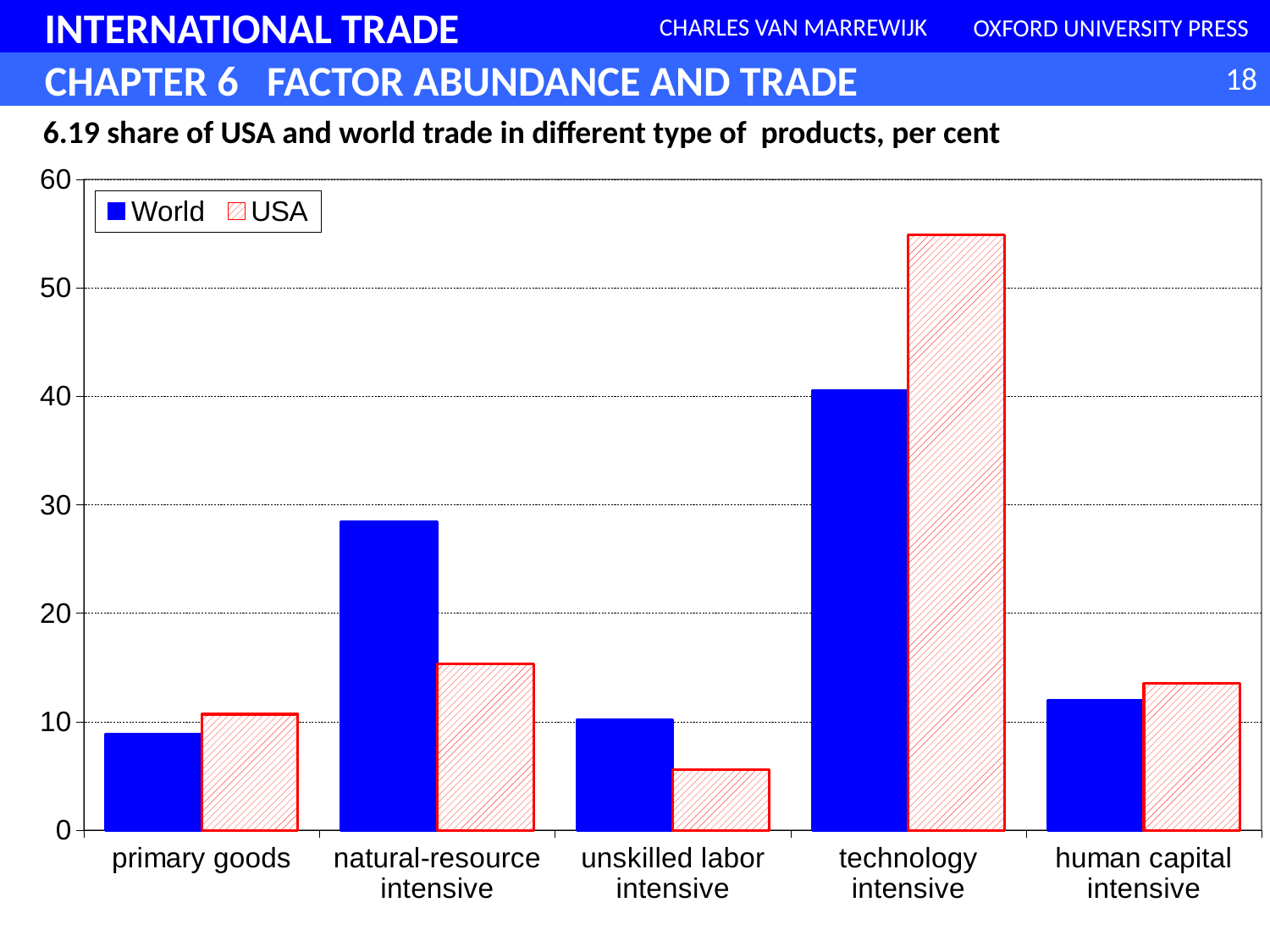
Is the USA value for technology intensive products greater or less than 50? greater For natural-resource intensive products, which is larger, the World share or the USA share? World For which product category is the USA share highest? technology intensive Is the USA value for unskilled labor intensive products greater or less than 10? less How many series does the legend list? 2 For which product category is the USA share lowest? unskilled labor intensive What kind of chart is shown on the slide? bar chart Which two series are listed in the legend? World and USA For which product category is the World share highest? technology intensive For technology intensive products, which is larger, the World share or the USA share? USA Is the World value for natural-resource intensive products greater or less than 30? less How many product categories are shown on the x axis? 5